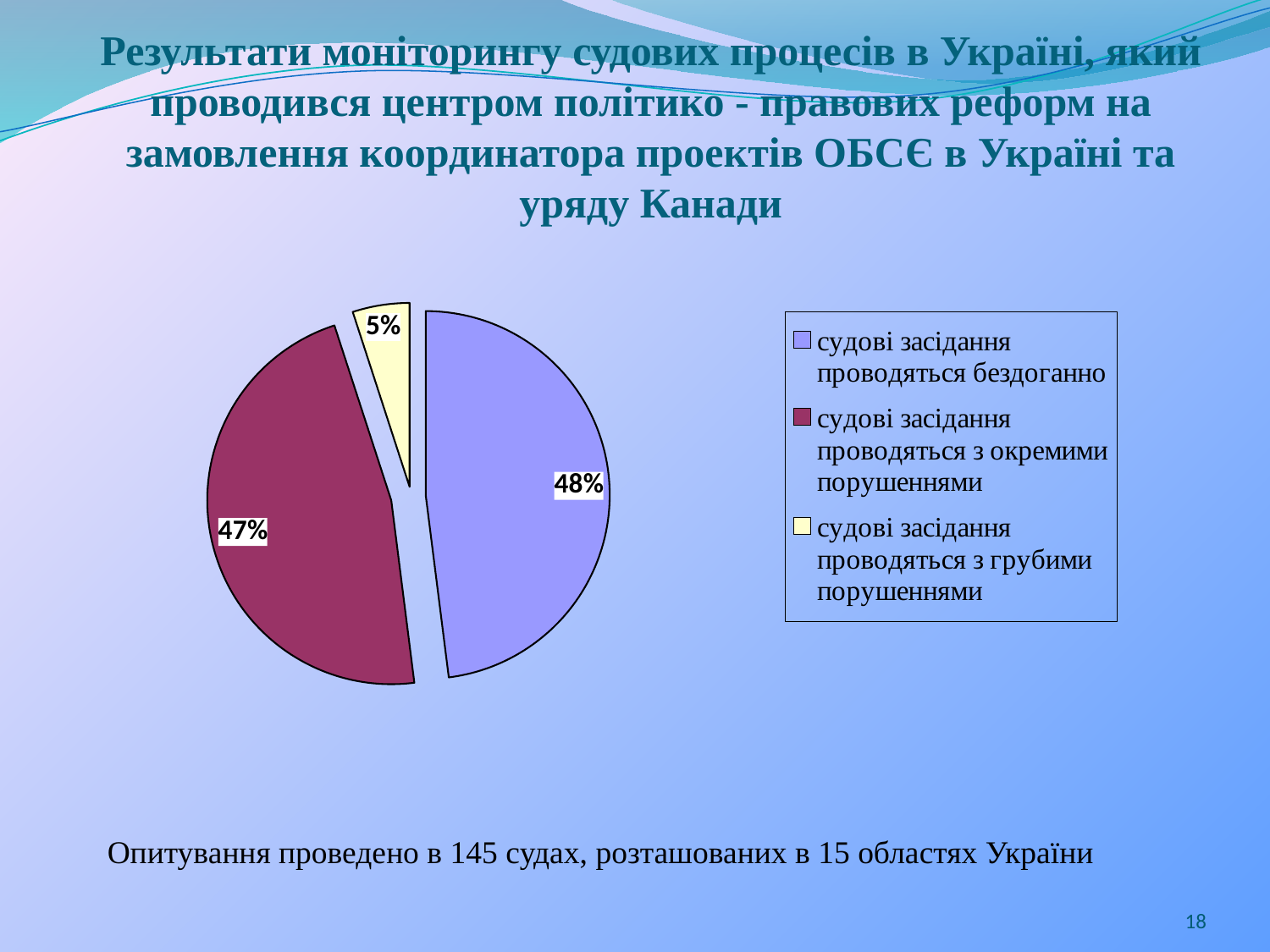
What kind of chart is shown on the slide? pie chart What colour is the slice for 'судові засідання проводяться бездоганно'? light purple What share of the pie is labelled 'судові засідання проводяться з грубими порушеннями'? 5% Which category has the smallest slice of the pie? судові засідання проводяться з грубими порушеннями How many slices does the pie chart have? 3 How many entries does the legend list? 3 What colour is the slice for 'судові засідання проводяться з грубими порушеннями'? light yellow What share of the pie is labelled 'судові засідання проводяться бездоганно'? 48% What is the difference in percentage points between the 48% slice and the 47% slice? 1% What share of the pie is labelled 'судові засідання проводяться з окремими порушеннями'? 47% Which is larger: the slice for 'судові засідання проводяться з окремими порушеннями' or the slice for 'судові засідання проводяться з грубими порушеннями'? судові засідання проводяться з окремими порушеннями What is the difference in percentage points between the slice for 'судові засідання проводяться бездоганно' and the slice for 'судові засідання проводяться з грубими порушеннями'? 43%